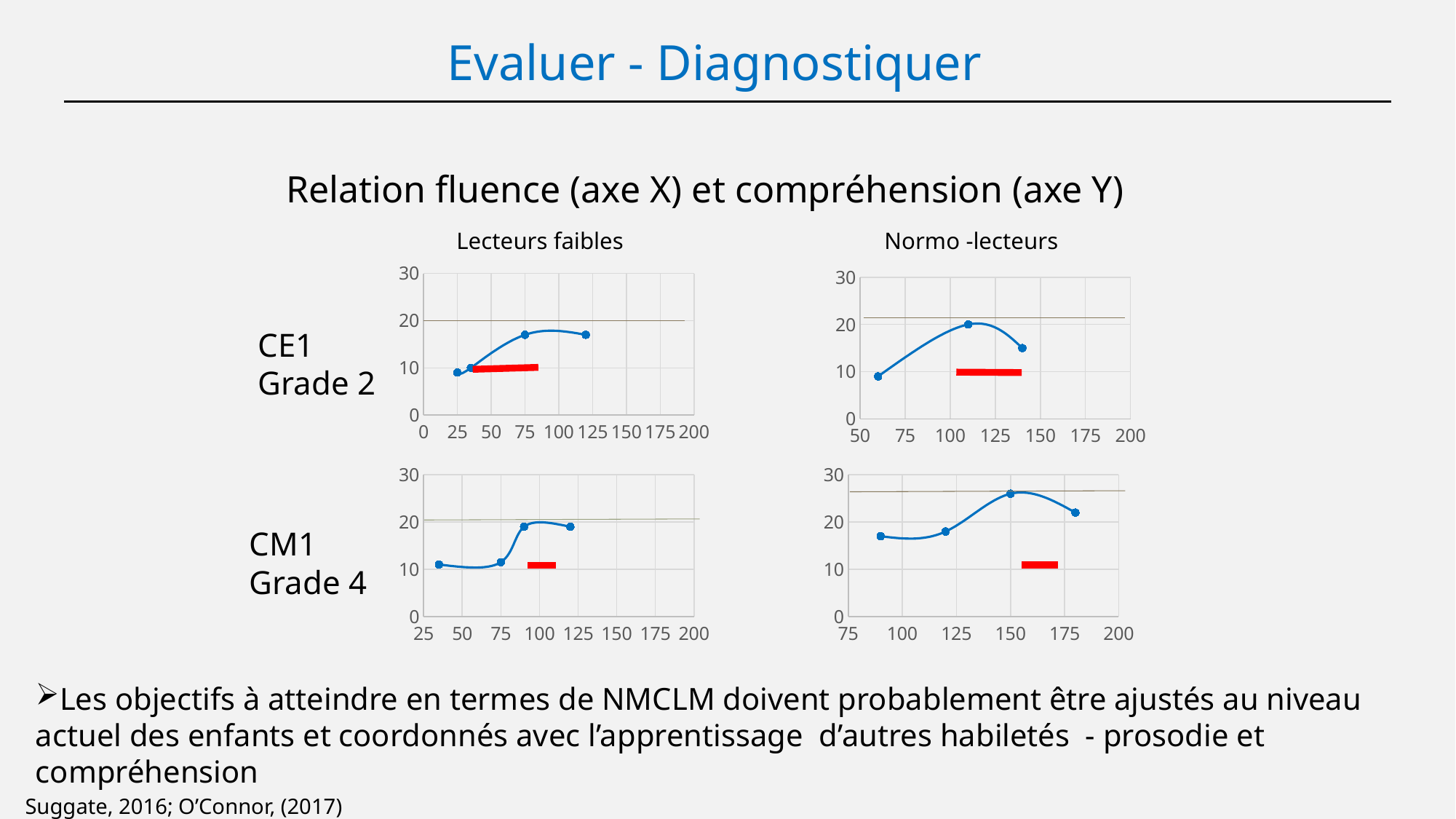
On the 'Normo -lecteurs' CM1 Grade 4 chart (bottom right), do the y values rise or fall between the third and fourth points? fall On the 'Normo -lecteurs' CM1 Grade 4 chart (bottom right), is the y value of the highest point greater or less than 20? greater What is the maximum value shown on the y axis of the 'Lecteurs faibles' CE1 Grade 2 chart (top left)? 30 On the 'Lecteurs faibles' CE1 Grade 2 chart (top left), is the y value of the highest point greater or less than 20? less On the 'Normo -lecteurs' CE1 Grade 2 chart (top right), do the y values rise or fall from the first point to the last point? rise How many data points are plotted on the 'Lecteurs faibles' CM1 Grade 4 chart (bottom left)? 4 What is the first x-axis tick value on the 'Normo -lecteurs' CM1 Grade 4 chart (bottom right)? 75 On the 'Lecteurs faibles' CM1 Grade 4 chart (bottom left), is the y value of the leftmost point greater or less than 20? less How many data points are plotted on the 'Normo -lecteurs' CM1 Grade 4 chart (bottom right)? 4 What kind of chart is the 'Lecteurs faibles' CE1 Grade 2 chart (top left)? line chart How many data points are plotted on the 'Normo -lecteurs' CE1 Grade 2 chart (top right)? 3